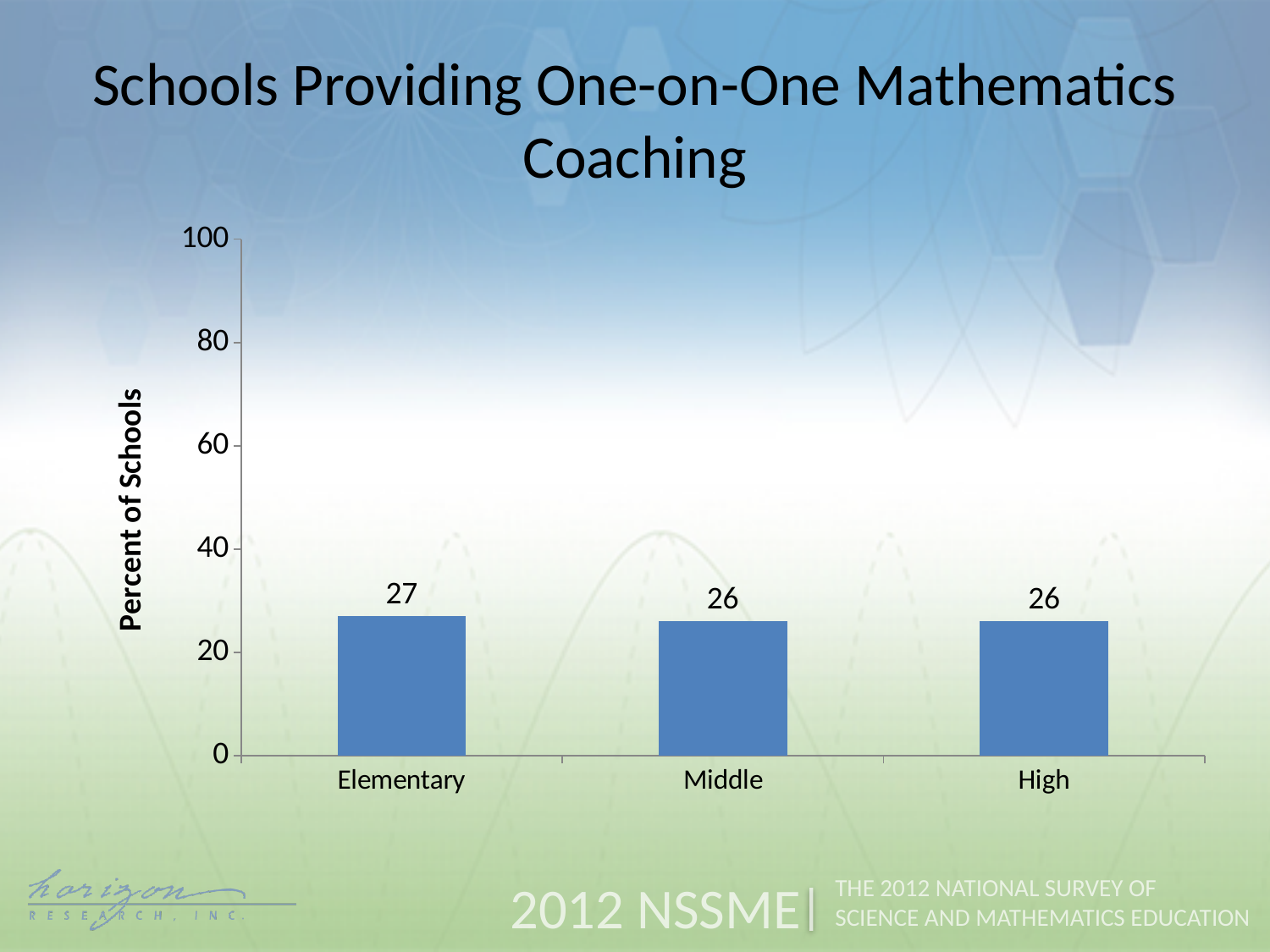
How many school levels are shown in the chart? 3 Is the value for High schools greater or less than 20? greater What is the value for High schools in the chart? 26 What is the difference between the values for Elementary and Middle schools? 1 Which school level has the highest percent of schools providing one-on-one mathematics coaching? Elementary What is the maximum value shown on the vertical axis? 100 What percent of elementary schools provide one-on-one mathematics coaching? 27 What is the title of the chart? Schools Providing One-on-One Mathematics Coaching Is the value for Elementary schools greater or less than 40? less What type of chart is shown on the slide? bar chart What is the label of the vertical axis? Percent of Schools What is the value for Middle schools in the chart? 26